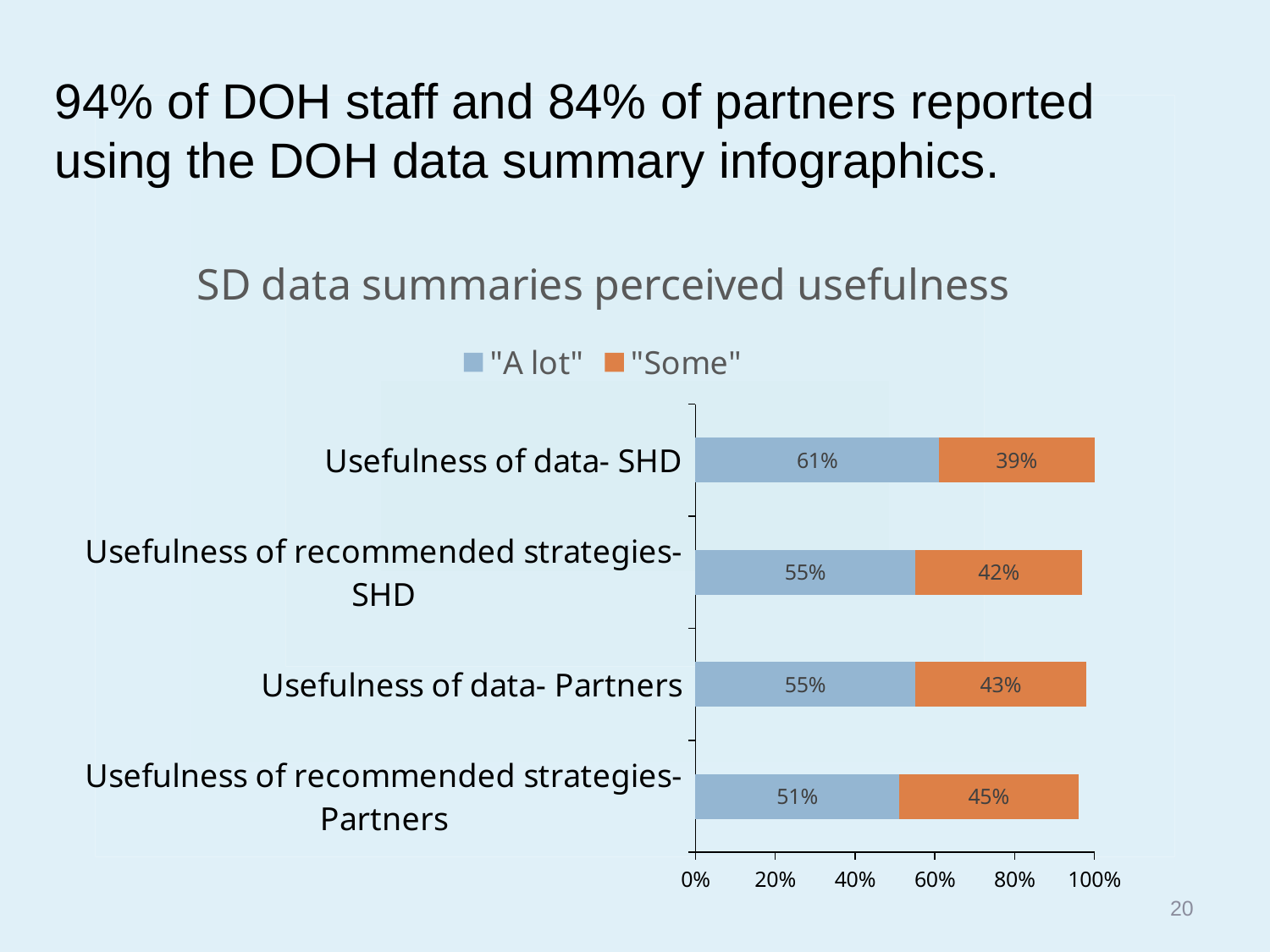
What is the "A lot" value for Usefulness of data- SHD? 61% Which is larger: the "Some" value for Usefulness of data- SHD or for Usefulness of recommended strategies- Partners? Usefulness of recommended strategies- Partners How many categories are shown in the chart? 4 What is the "Some" value for Usefulness of recommended strategies- Partners? 45% What is the "Some" value for Usefulness of data- Partners? 43% What is the total of the stacked bar for Usefulness of data- SHD? 100% What is the total of the stacked bar for Usefulness of recommended strategies- SHD? 97% Which category has the lowest "A lot" value? Usefulness of recommended strategies- Partners How many series does the legend list? 2 Which category has the highest "A lot" value? Usefulness of data- SHD What type of chart is shown? Stacked bar chart What is the difference between the "A lot" values for Usefulness of data- SHD and Usefulness of recommended strategies- Partners? 10%